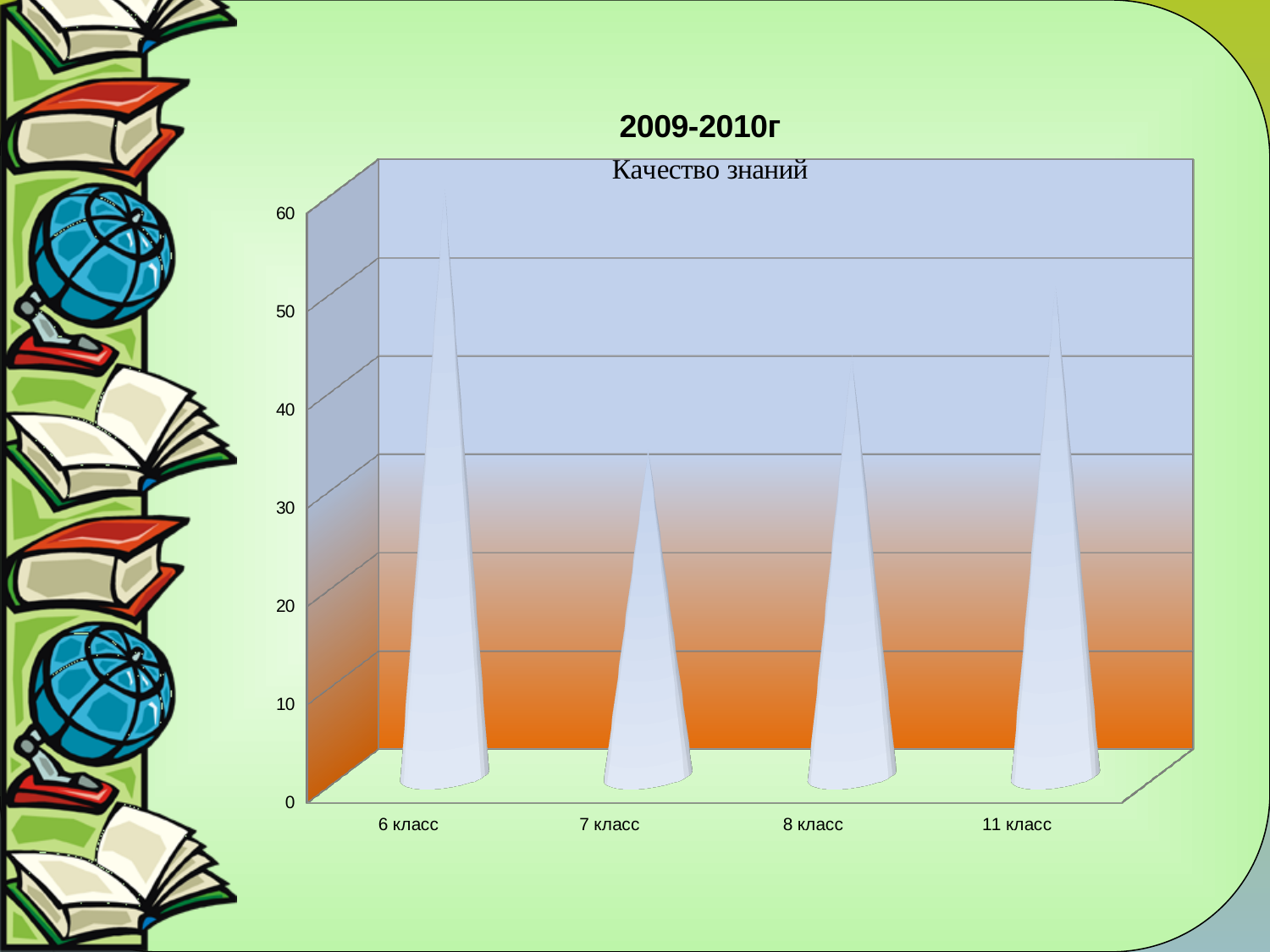
Is the value for 8 класс greater or less than 30? greater Which has the larger value, 8 класс or 11 класс? 11 класс Is the value for 6 класс greater or less than 50? greater Which category has the lowest value in the chart? 7 класс What kind of chart is shown on the slide? bar chart Is the value for 11 класс greater or less than 40? greater How many categories are shown on the x axis of the chart? 4 What is the title of the chart? Качество знаний Which category has the highest value in the chart? 6 класс What school year is given in the heading above the chart? 2009-2010г Which has the larger value, 6 класс or 7 класс? 6 класс